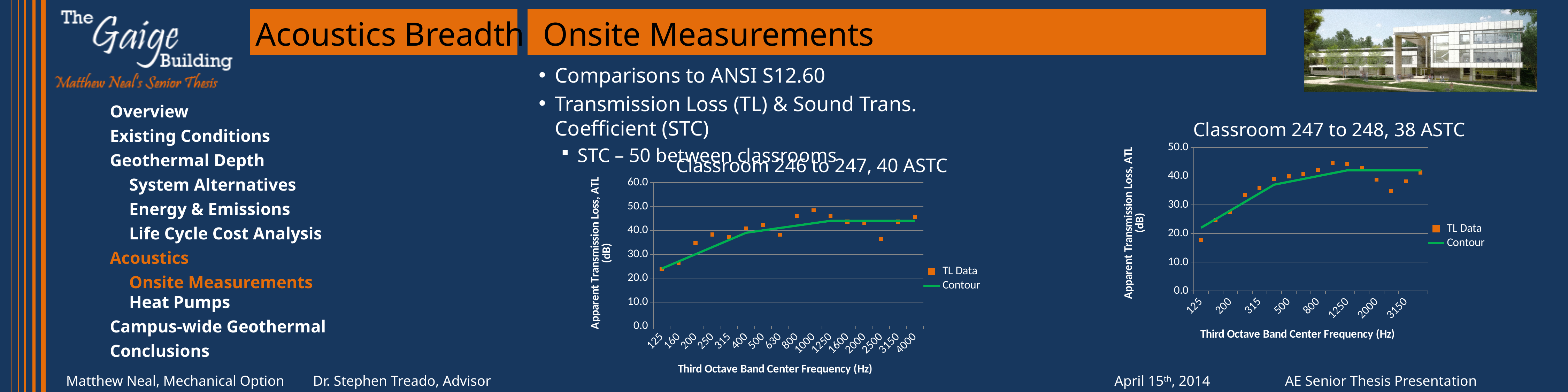
How many frequency categories are labelled on the x axis of the 'Classroom 246 to 247, 40 ASTC' chart? 16 In the 'Classroom 246 to 247, 40 ASTC' chart, is the TL Data value at 125 Hz greater or less than 30.0? less In the 'Classroom 246 to 247, 40 ASTC' chart, does the Contour line generally rise or fall as frequency increases from 125 Hz to 4000 Hz? rise In the 'Classroom 247 to 248, 38 ASTC' chart, which is larger: the TL Data value at 125 Hz or at 500 Hz? 500 Hz In the 'Classroom 246 to 247, 40 ASTC' chart, is the TL Data value at 1000 Hz greater or less than 40.0? greater How many series does the legend of the 'Classroom 247 to 248, 38 ASTC' chart list? 2 In the 'Classroom 247 to 248, 38 ASTC' chart, is the TL Data value at 1250 Hz greater or less than 40.0? greater What kind of chart is 'Classroom 246 to 247, 40 ASTC'? line chart What are the two legend entries on the 'Classroom 246 to 247, 40 ASTC' chart? TL Data and Contour What is the highest value shown on the y axis of the 'Classroom 247 to 248, 38 ASTC' chart? 50.0